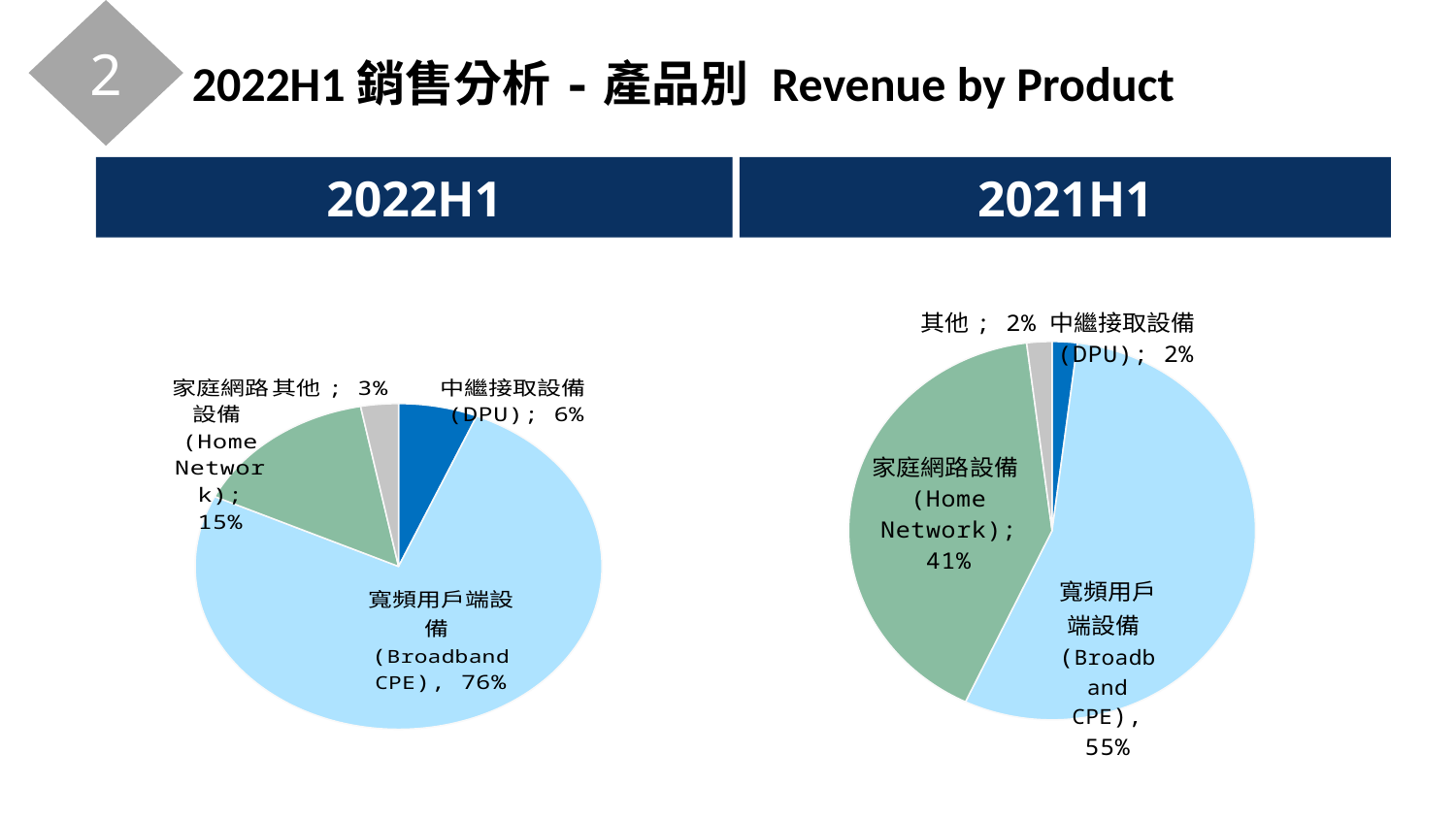
How many slices does the 2022H1 pie chart have? 4 In the 2021H1 pie chart, what share does Home Network (家庭網路設備) have? 41% In the 2022H1 pie chart, which category has the smallest share? 其他 (Other) In the 2021H1 pie chart, what is the difference between the Broadband CPE share and the Home Network share? 14% In the 2022H1 pie chart, what share does Broadband CPE (寬頻用戶端設備) have? 76% In the 2022H1 pie chart, what is the value for DPU (中繼接取設備)? 6% In the 2021H1 pie chart, which category has the largest share? 寬頻用戶端設備 (Broadband CPE) In the 2022H1 pie chart, what is the difference between the Broadband CPE share and the Home Network share? 61% In the 2021H1 pie chart, what is the value for 其他 (Other)? 2% In the 2022H1 pie chart, which category has the largest share? 寬頻用戶端設備 (Broadband CPE) What type of chart is used on the left side of the slide for 2022H1? Pie chart Is the Home Network share larger in the 2022H1 chart or the 2021H1 chart? 2021H1